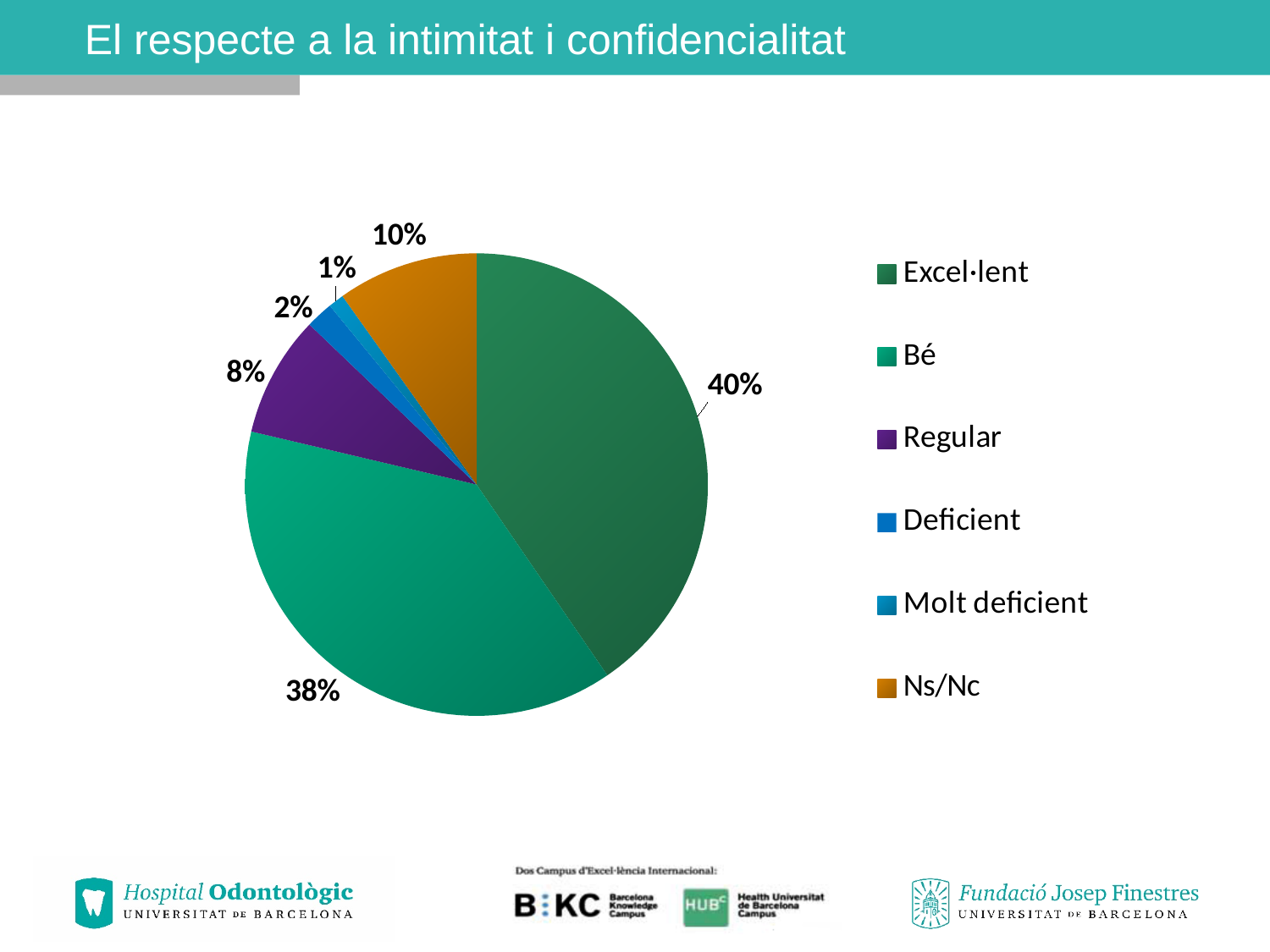
What percentage does the Regular slice show? 8% What kind of chart is shown on the slide? Pie chart What is the difference in percentage points between the Excel·lent and Bé slices? 2 What is the title of the slide containing the chart? El respecte a la intimitat i confidencialitat Which category has the smallest slice of the pie? Molt deficient How many categories does the legend list? 6 What percentage does the Molt deficient slice show? 1% What percentage does the Ns/Nc slice show? 10% What share of the pie is labelled Excel·lent? 40% What share of the pie is labelled Bé? 38% Which category has the largest slice of the pie? Excel·lent Which is larger, the Ns/Nc slice or the Regular slice? Ns/Nc